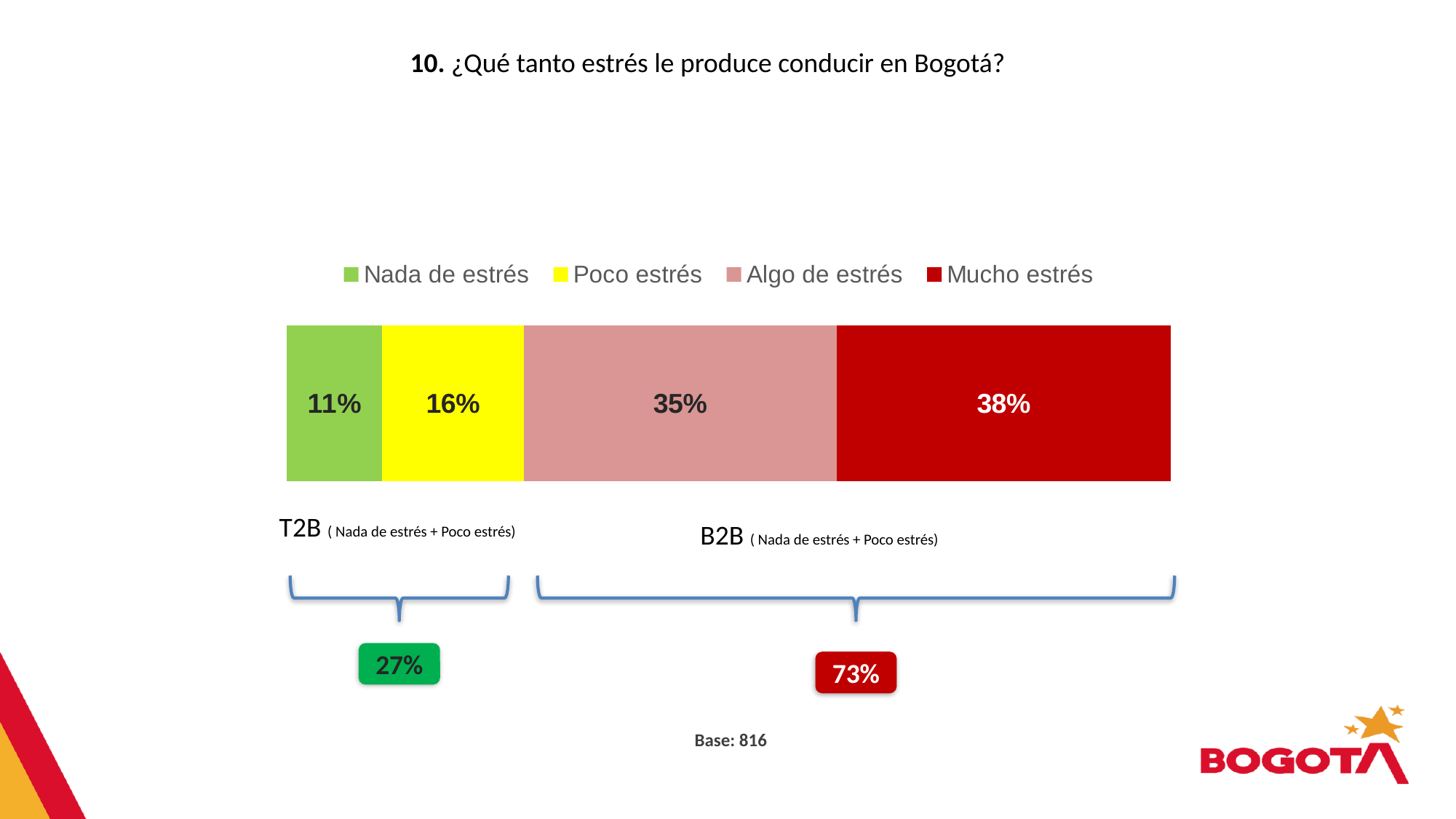
What kind of chart is shown on the slide? Stacked bar chart What percentage of respondents answered "Poco estrés"? 16% Which response category has the highest percentage? Mucho estrés What is the T2B value shown below the bar? 27% What percentage of respondents answered "Algo de estrés"? 35% What percentage of respondents answered "Nada de estrés"? 11% What percentage of respondents answered "Mucho estrés"? 38% Which is larger, the share for "Algo de estrés" or the share for "Poco estrés"? Algo de estrés How many series does the legend list? 4 What is the difference in percentage points between "Mucho estrés" and "Nada de estrés"? 27 What is the base (number of respondents) shown on the slide? 816 Which response category has the lowest percentage? Nada de estrés